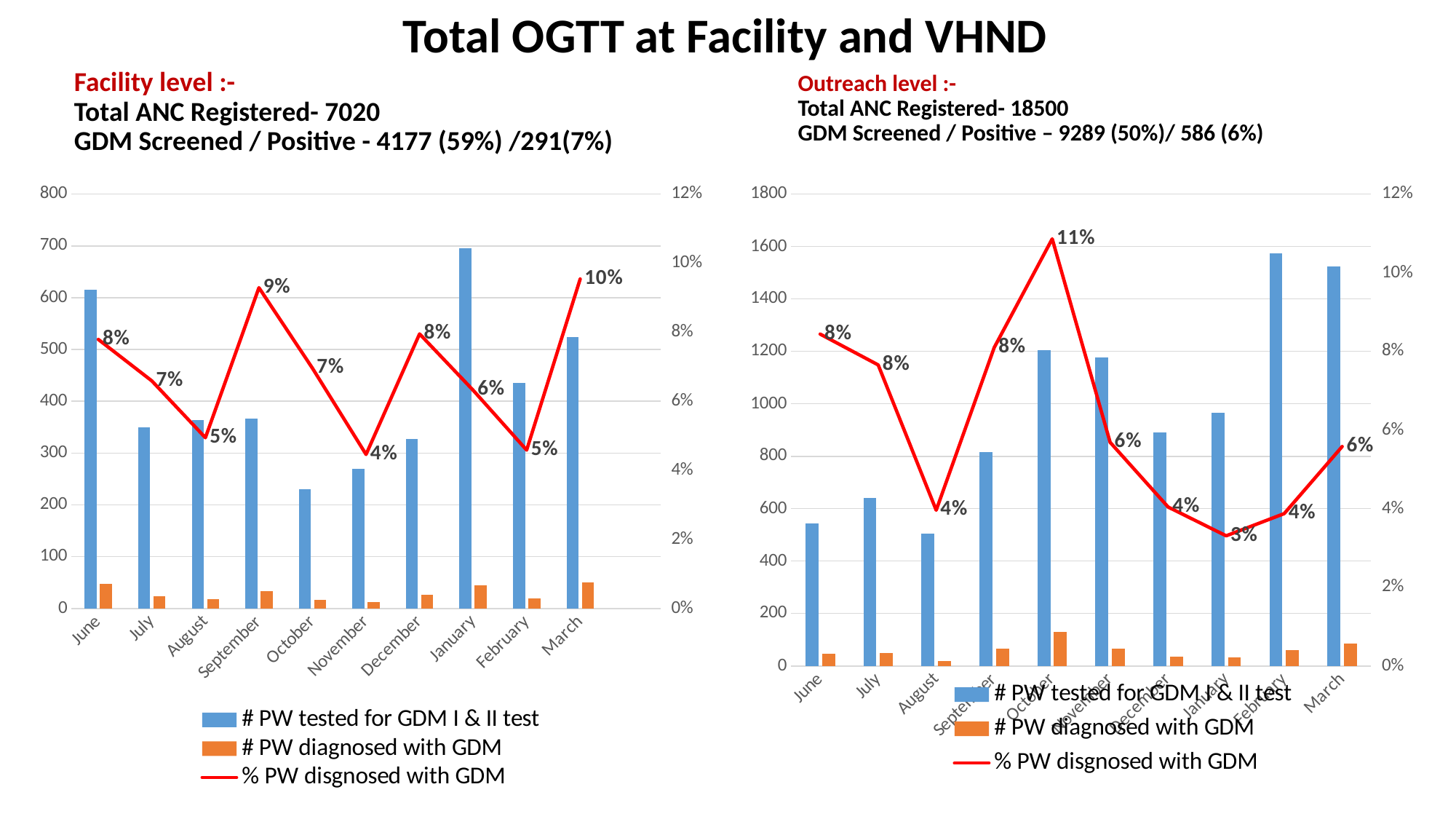
In the Outreach level chart, which series is drawn as a red line? % PW disgnosed with GDM In the Facility level chart, is the number of PW tested for GDM I & II test in January greater or less than 600? greater What kind of chart is the Facility level chart? Combined bar and line chart In the Facility level chart, what is the % PW diagnosed with GDM in March? 10% In the Outreach level chart, which month has the lowest % PW diagnosed with GDM? January In the Facility level chart, what is the difference between the % PW diagnosed with GDM in September and in November? 5% In the Outreach level chart, is the number of PW tested for GDM I & II test in February greater or less than 1400? greater In the Outreach level chart, what is the % PW diagnosed with GDM in October? 11% How many series does the legend of the Outreach level chart list? 3 In the Outreach level chart, is the % PW diagnosed with GDM higher in June or in August? June In the Facility level chart, which month has the highest % PW diagnosed with GDM? March How many months are shown on the x axis of the Facility level chart? 10